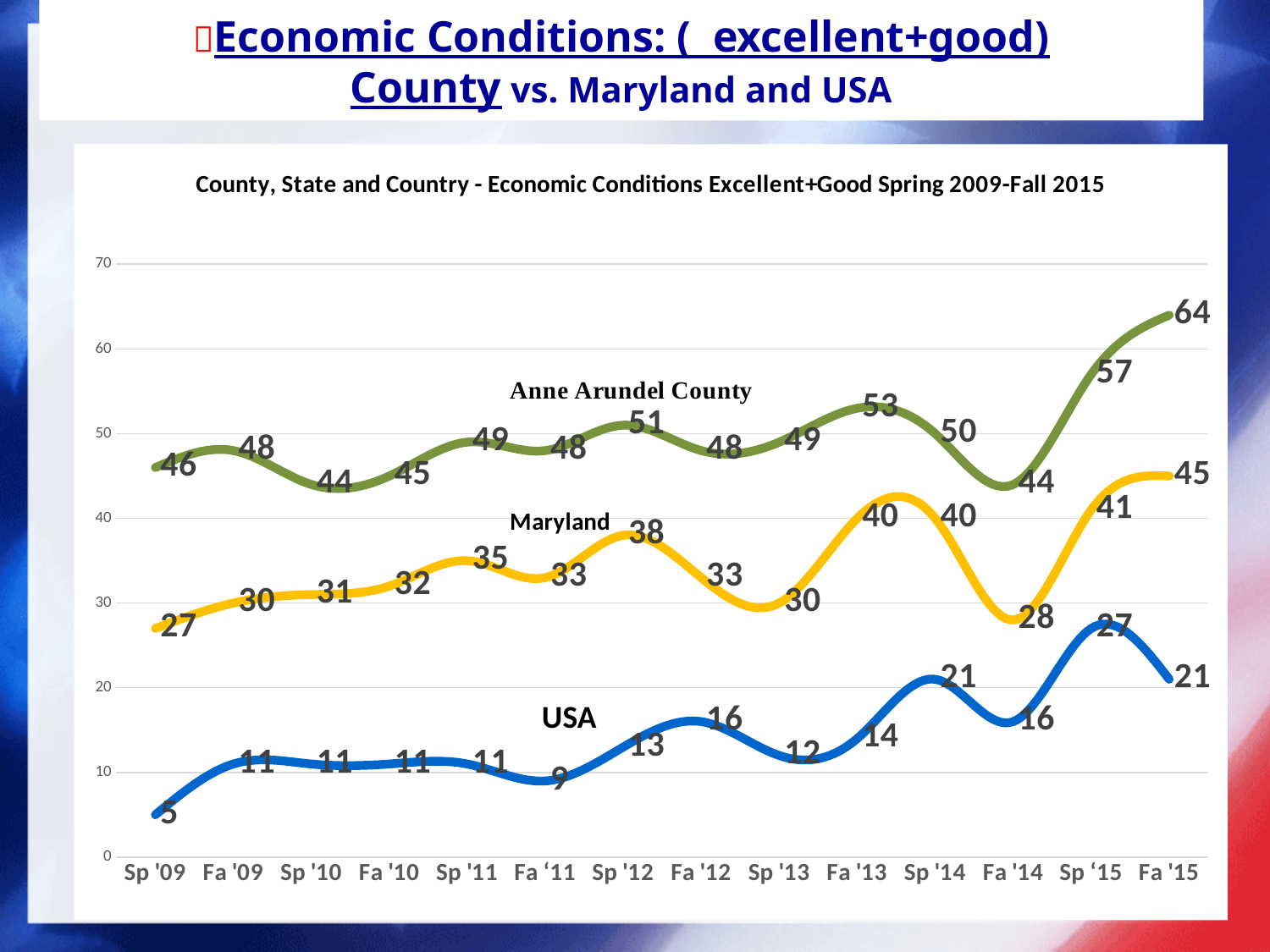
In which period does Anne Arundel County have its lowest value? Sp '10 and Fa '14 (both 44) What is the value for Anne Arundel County in Fa '15? 64 What kind of chart is shown on the slide? Line chart What is the value for USA in Sp '09? 5 How many series are plotted on the chart? 3 Does the Anne Arundel County series rise or fall from Fa '14 to Fa '15? Rise What is the value for Maryland in Fa '14? 28 How many time periods are shown on the x axis? 14 Which is larger in Sp '14: the Maryland value or the USA value? Maryland What is the value for Maryland in Sp '12? 38 In which period does the USA series reach its highest value? Sp '15 What is the difference between Anne Arundel County and Maryland in Fa '15? 19